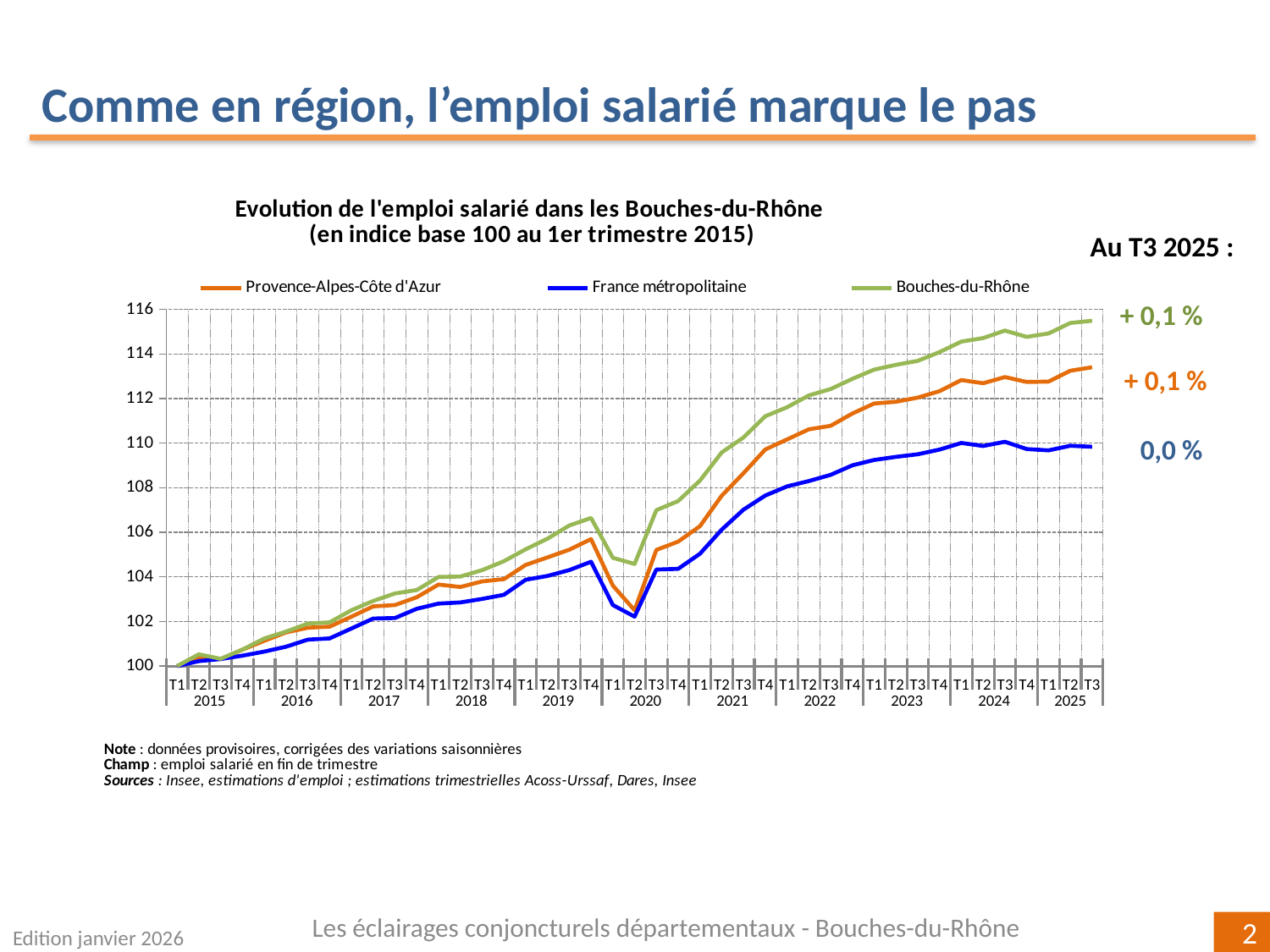
Which series has the lowest value at T3 2025? France métropolitaine Is the value for France métropolitaine at T2 2020 greater or less than 104? less Is the value for Provence-Alpes-Côte d'Azur at T3 2025 greater or less than 112? greater At T3 2025, which is larger: Provence-Alpes-Côte d'Azur or France métropolitaine? Provence-Alpes-Côte d'Azur Do the values for Bouches-du-Rhône rise or fall overall from 2015 to 2025? rise How many years are labelled on the x axis? 11 What change is annotated for France métropolitaine at T3 2025? 0,0 % What kind of chart is shown on the slide? line chart What is the value of all three series at T1 2015? 100 How many series does the legend list? 3 Is the value for Bouches-du-Rhône at T3 2025 greater or less than 114? greater Which series has the highest value at T3 2025? Bouches-du-Rhône